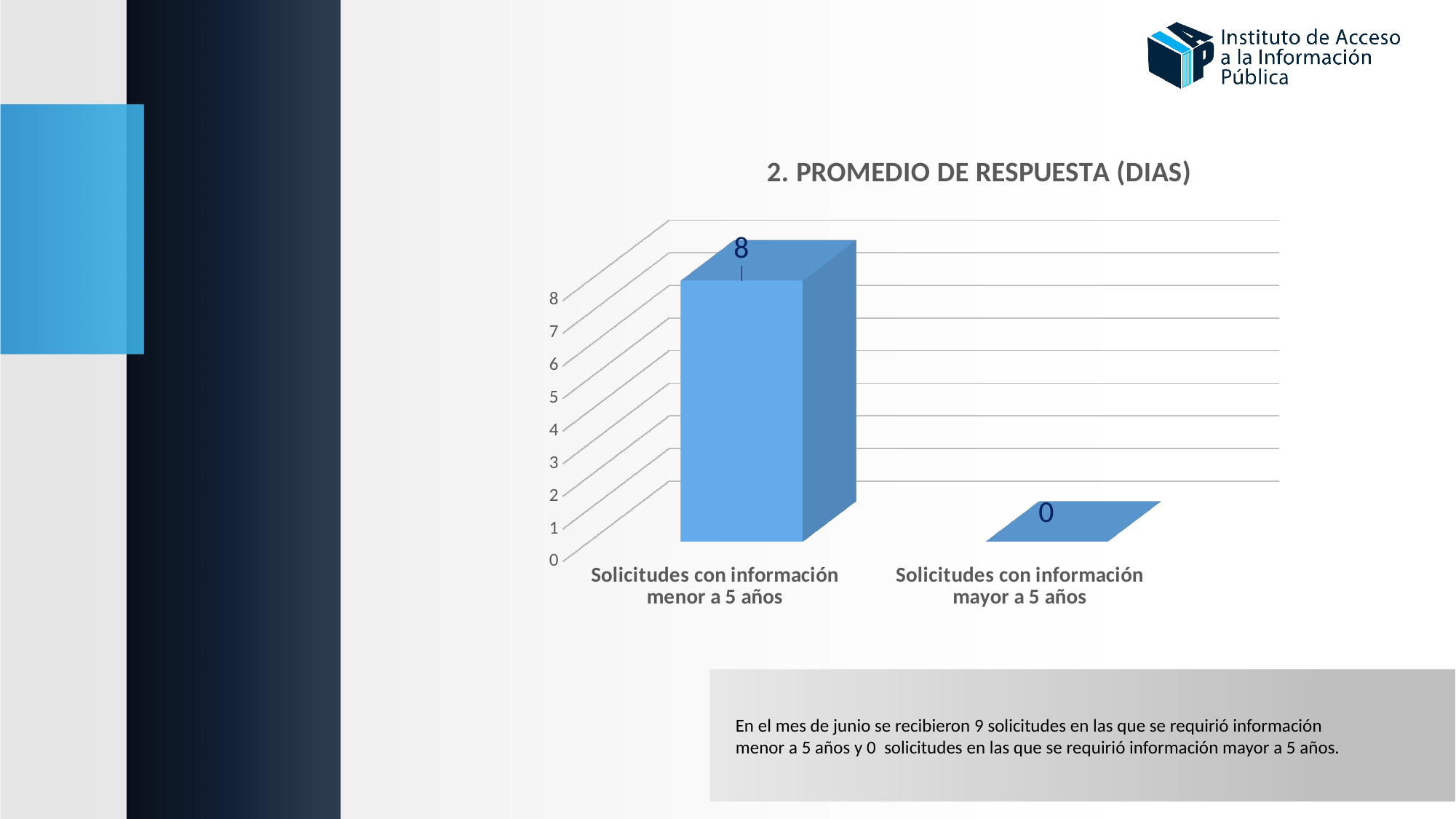
What is the difference between the values for 'Solicitudes con información menor a 5 años' and 'Solicitudes con información mayor a 5 años'? 8 How many categories are shown on the x axis? 2 Which is larger: the value for 'Solicitudes con información menor a 5 años' or 'Solicitudes con información mayor a 5 años'? Solicitudes con información menor a 5 años What is the value for 'Solicitudes con información mayor a 5 años'? 0 What kind of chart is shown on the slide? bar chart Which category has the lowest value? Solicitudes con información mayor a 5 años Is the value for 'Solicitudes con información menor a 5 años' greater or less than 5? greater What is the value for 'Solicitudes con información menor a 5 años'? 8 Which category has the highest value? Solicitudes con información menor a 5 años What is the highest value shown on the vertical axis? 8 What is the title of the chart? 2. PROMEDIO DE RESPUESTA (DIAS)